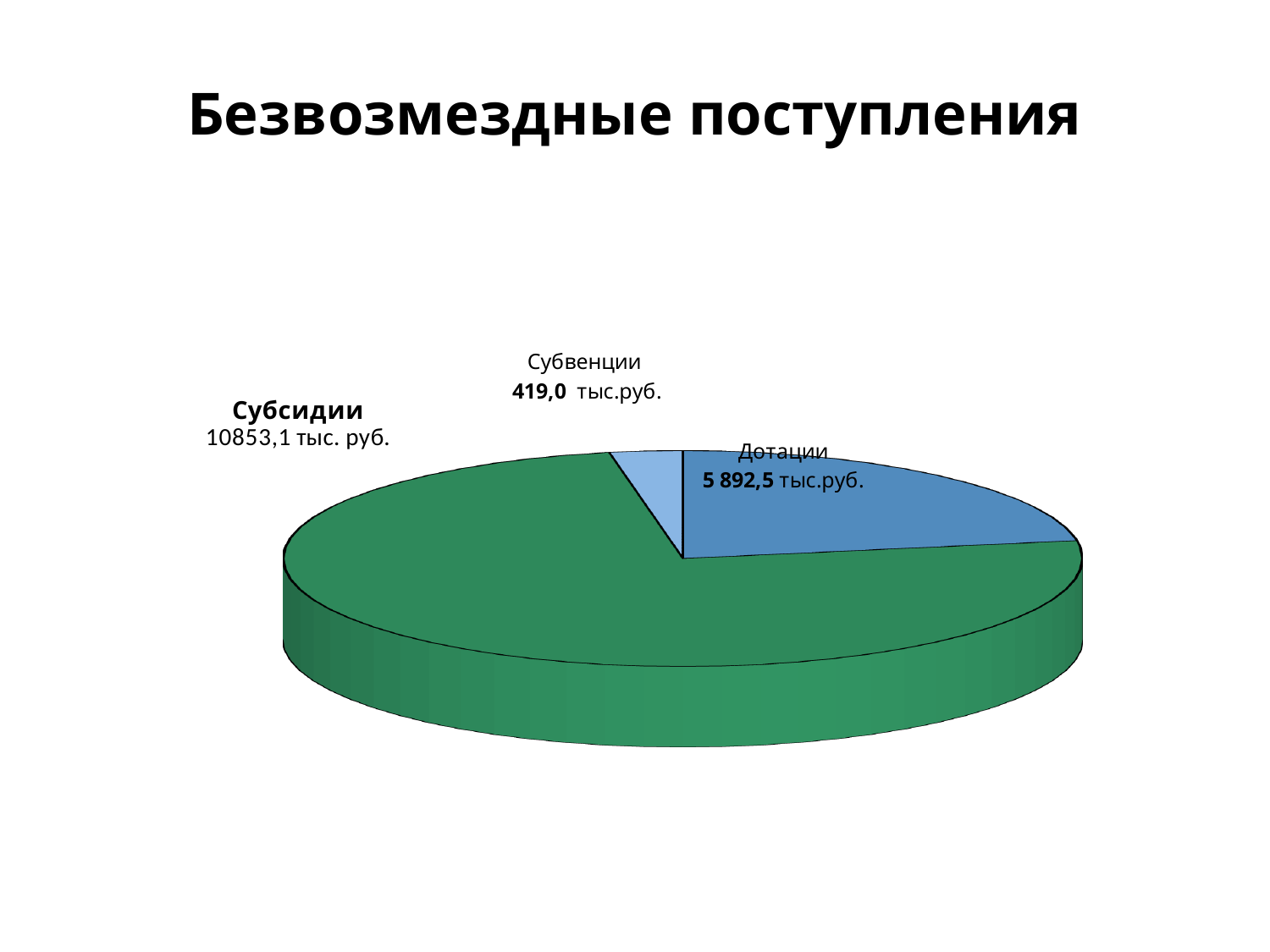
Which is larger, Дотации or Субвенции? Дотации What is the title of the chart? Безвозмездные поступления What is the total of all three slices? 17164,6 тыс. руб. Which category has the largest slice of the pie? Субсидии What is the value for Субвенции? 419,0 тыс.руб. What is the difference between Субсидии and Дотации? 4960,6 тыс. руб. Which category has the smallest slice of the pie? Субвенции How many categories are shown in the pie chart? 3 What is the value for Дотации? 5 892,5 тыс.руб. What is the value for Субсидии? 10853,1 тыс. руб. What is the difference between Дотации and Субвенции? 5473,5 тыс. руб. What kind of chart is shown on the slide? Pie chart